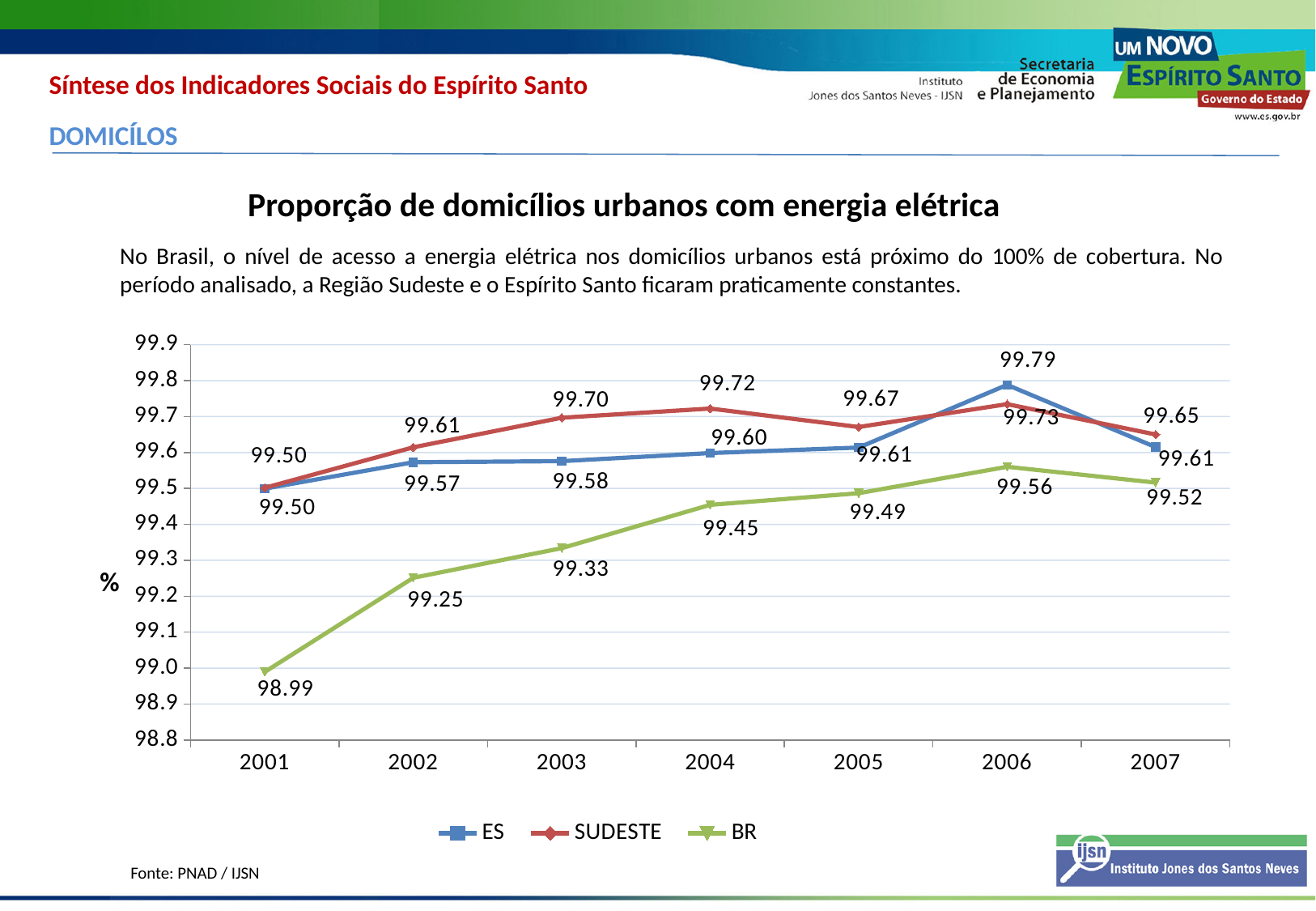
What is the value for ES in 2006? 99.79 In which year does the SUDESTE series have its lowest value? 2001 How many series does the legend list? 3 What is the title of the chart? Proporção de domicílios urbanos com energia elétrica What is the difference between the SUDESTE and BR values in 2003? 0.37 What is the value for BR in 2001? 98.99 In which year does the BR series reach its highest value? 2006 What is the value for SUDESTE in 2004? 99.72 Does the BR series generally rise or fall from 2001 to 2006? rise Which series has the higher value in 2007, ES or SUDESTE? SUDESTE What type of chart is shown on the slide? line chart How many years are plotted on the x axis? 7